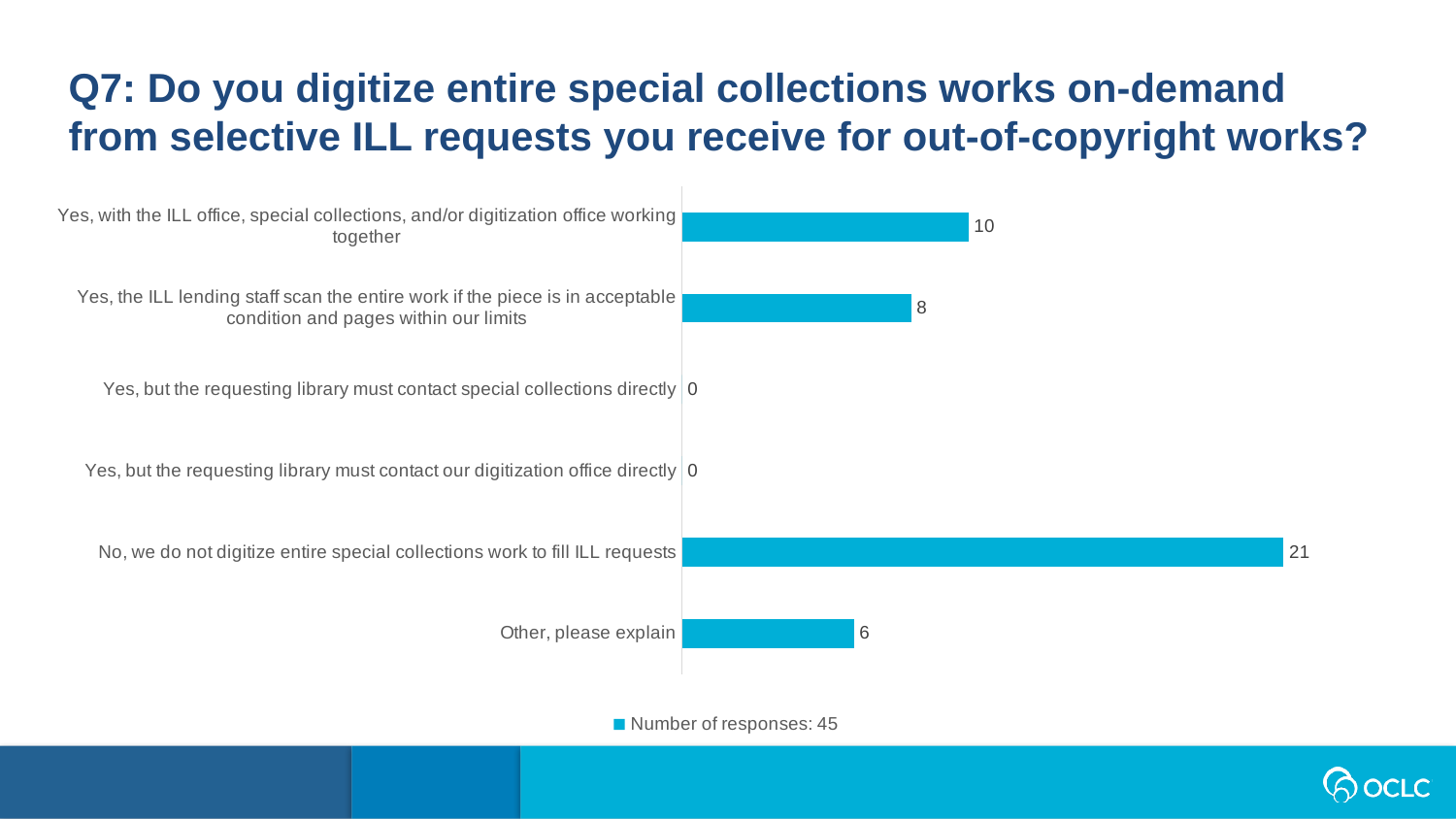
Which is larger: the value for "Yes, the ILL lending staff scan the entire work..." or the value for "Other, please explain"? Yes, the ILL lending staff scan the entire work if the piece is in acceptable condition and pages within our limits How many series does the legend list? 1 Which category has the highest number of responses? No, we do not digitize entire special collections work to fill ILL requests How many categories have a value of 0? 2 What is the difference between the values for "No, we do not digitize entire special collections work to fill ILL requests" and "Yes, with the ILL office, special collections, and/or digitization office working together"? 11 What type of chart is shown on the slide? Bar chart What is the value for "Yes, with the ILL office, special collections, and/or digitization office working together"? 10 What does the legend entry say? Number of responses: 45 What is the value for "Yes, the ILL lending staff scan the entire work if the piece is in acceptable condition and pages within our limits"? 8 What is the value for "Other, please explain"? 6 How many responses are shown for "No, we do not digitize entire special collections work to fill ILL requests"? 21 How many categories are plotted in the chart? 6